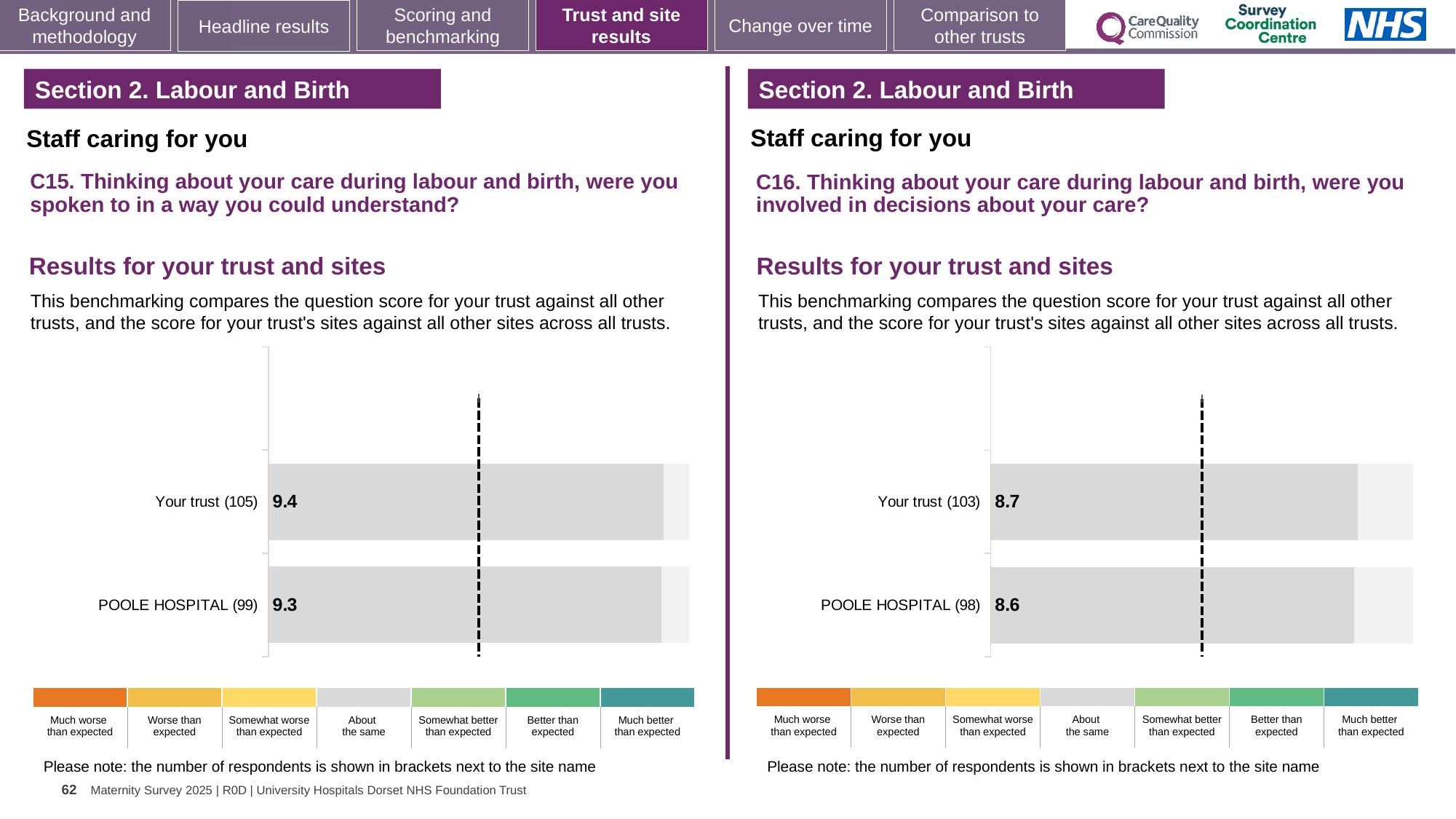
In the C16 chart on the right, which bar has the lowest score? POOLE HOSPITAL In the C15 chart on the left, what is the difference between the Your trust score and the POOLE HOSPITAL score? 0.1 In the C15 chart on the left, what is the score for Your trust? 9.4 In the C16 chart on the right, how many respondents are shown in brackets for POOLE HOSPITAL? 98 In the C16 chart on the right, what is the difference between the Your trust score and the POOLE HOSPITAL score? 0.1 How many bars are plotted in the C15 chart on the left? 2 In the C16 chart on the right, what is the score for Your trust? 8.7 What type of chart is used for the C16 results on the right? Bar chart In the C15 chart on the left, what is the score for POOLE HOSPITAL? 9.3 In the C15 chart on the left, how many respondents are shown in brackets for Your trust? 105 In the C15 chart on the left, which has the higher score, Your trust or POOLE HOSPITAL? Your trust In the C16 chart on the right, what is the score for POOLE HOSPITAL? 8.6